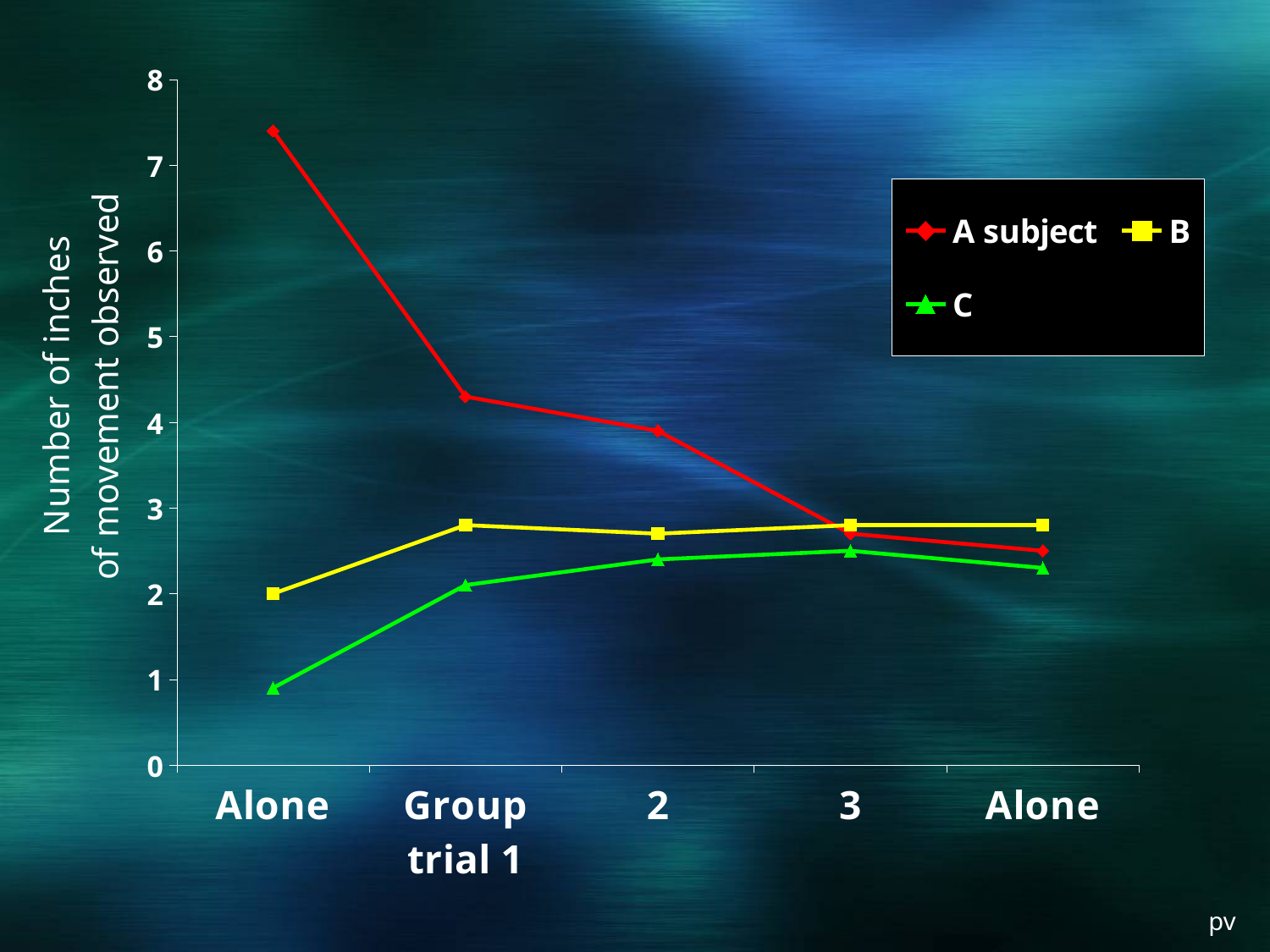
Is the value for A subject at the first Alone point greater or less than 7? greater At which x-axis point does A subject reach its highest value? Alone (first) What kind of chart is shown on the slide? line chart Does the A subject line rise or fall from the first Alone point to the last Alone point? fall Is the value for A subject at trial 3 greater or less than 3? less How many series does the legend list? 3 Is the value for A subject at Group trial 1 greater or less than 4? greater How many points are plotted along the x axis for each series? 5 At the first Alone point, which is larger: A subject or C? A subject Which series has the lowest value at the first Alone point? C